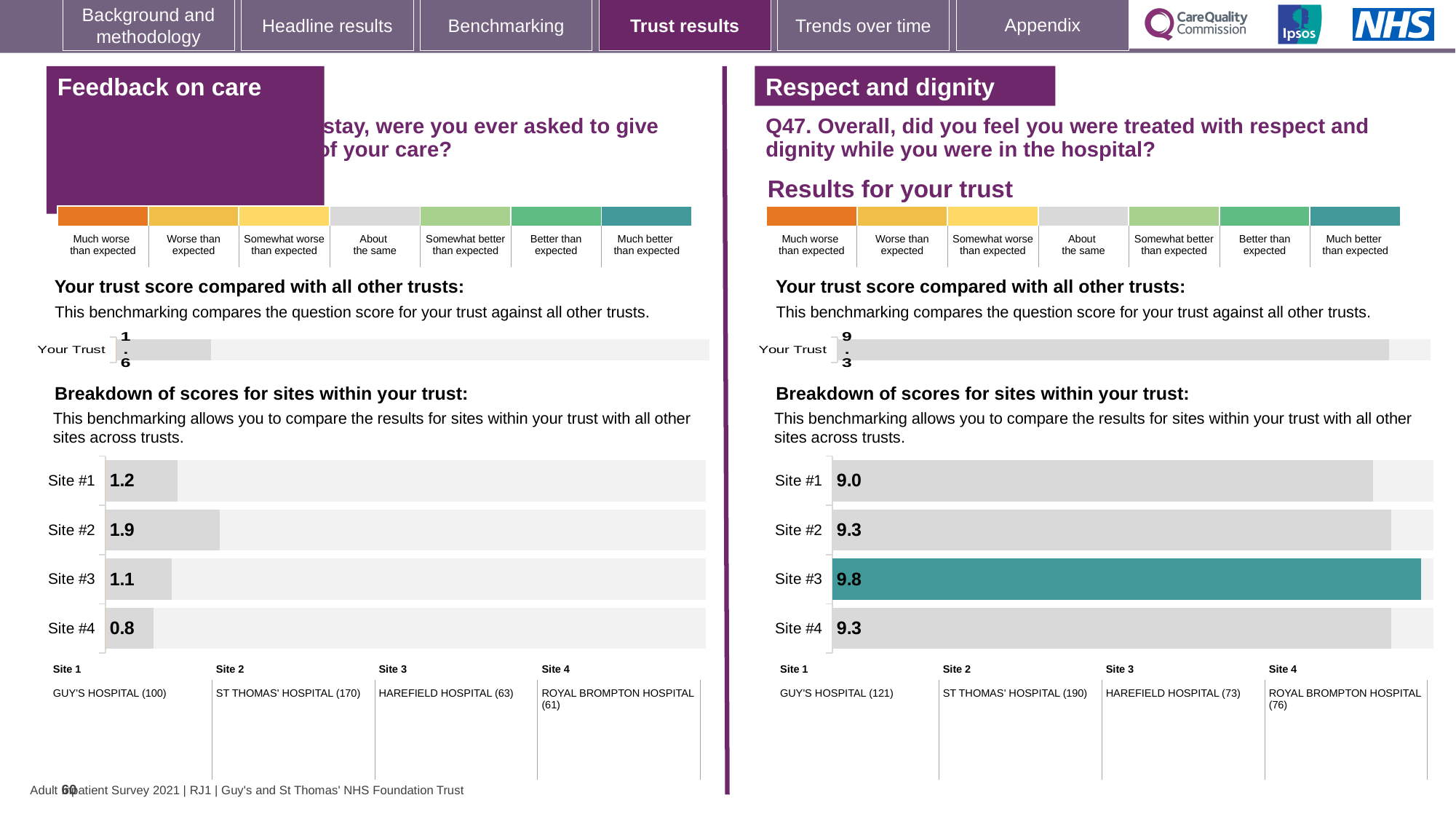
In the 'Respect and dignity' site breakdown chart, which site has the lowest score? Site #1 In the 'Feedback on care' site breakdown chart, what is the score for Site #2? 1.9 In the 'Feedback on care' site breakdown chart, which has the larger score, Site #1 or Site #3? Site #1 In the 'Respect and dignity' site breakdown chart, which site has the highest score? Site #3 In the 'Respect and dignity' site breakdown chart, what is the difference between the scores for Site #3 and Site #1? 0.8 What is the 'Your Trust' score shown in the 'Respect and dignity' trust comparison chart? 9.3 In the 'Respect and dignity' site breakdown chart, what is the score for Site #3? 9.8 In the 'Feedback on care' site breakdown chart, which site has the highest score? Site #2 What type of chart is used for the 'Feedback on care' breakdown of scores for sites? Bar chart In the 'Feedback on care' site breakdown chart, what is the difference between the scores for Site #2 and Site #4? 1.1 How many sites are shown in the 'Respect and dignity' site breakdown chart? 4 In the 'Feedback on care' site breakdown chart, which site has the lowest score? Site #4